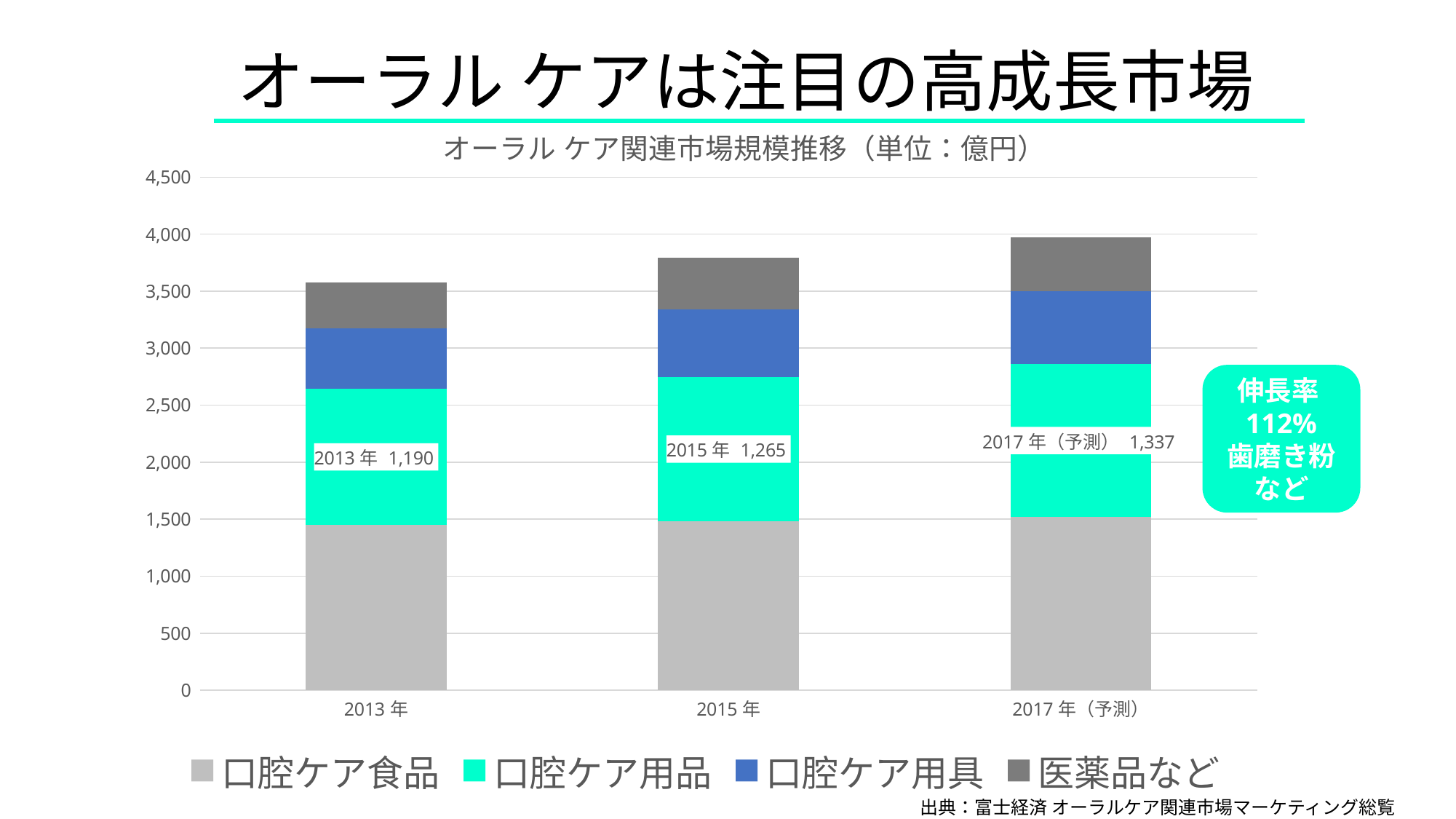
What kind of chart is shown on the slide? stacked bar chart How many series does the legend list? 4 What is the value for 口腔ケア用品 in 2013 年? 1,190 Which is larger, the 口腔ケア用品 value for 2013 年 or for 2015 年? 2015 年 What is the value for 口腔ケア用品 in 2015 年? 1,265 Which year has the highest 口腔ケア用品 value? 2017 年（予測） What is the difference between the 口腔ケア用品 values for 2015 年 and 2013 年? 75 Do the 口腔ケア用品 values rise or fall from 2013 年 to 2017 年（予測）? rise Is the total height of the 2015 年 bar greater or less than 3,500? greater What is the value for 口腔ケア用品 in 2017 年（予測）? 1,337 By how much does the 口腔ケア用品 value in 2017 年（予測） exceed the value in 2013 年? 147